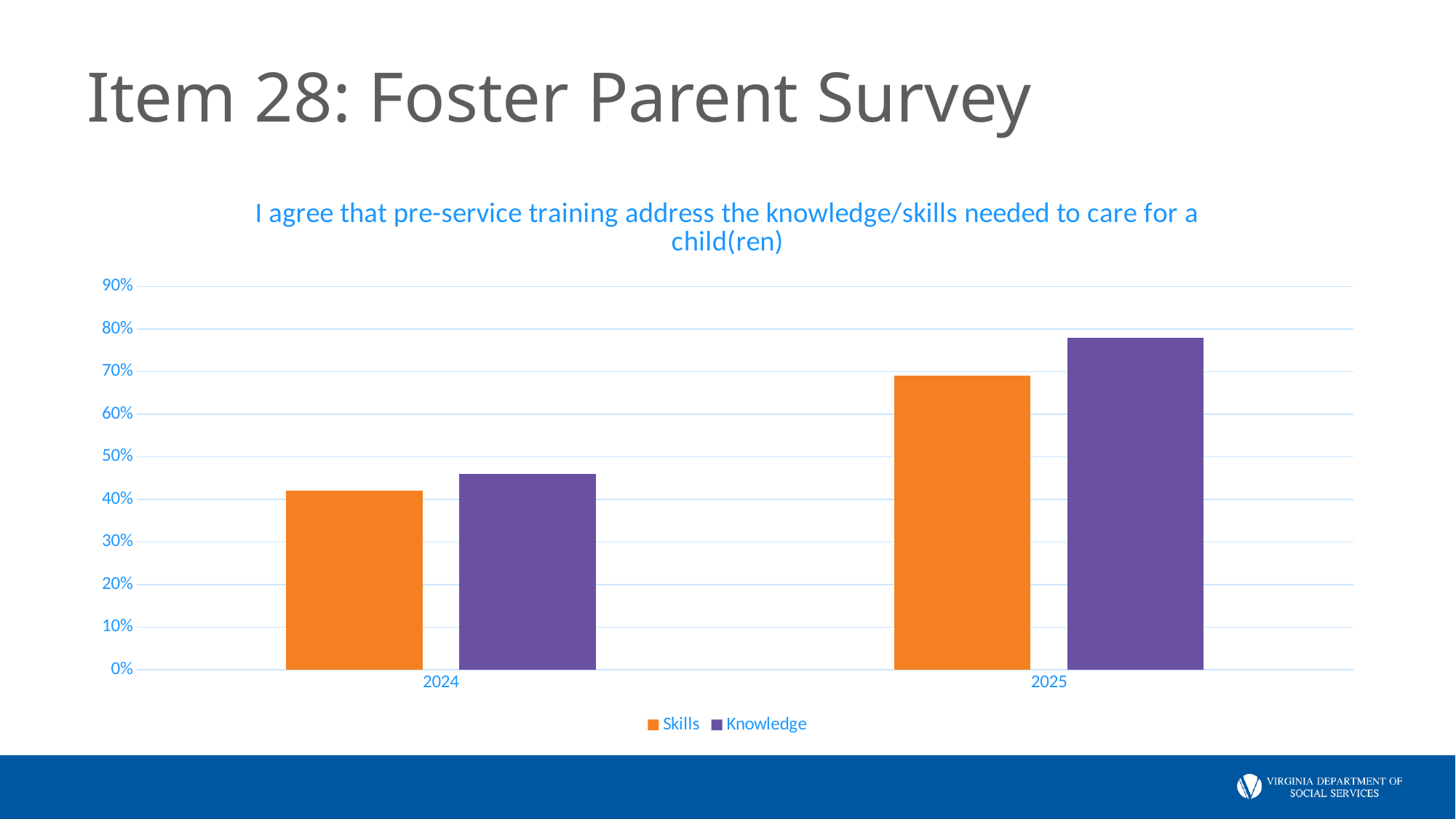
Is the value for Knowledge in 2024 greater or less than 50%? less Is the value for Skills in 2024 greater or less than 50%? less Which bar is the highest in the chart? Knowledge in 2025 Which series is shown in orange? Skills What is the title of the chart? I agree that pre-service training address the knowledge/skills needed to care for a child(ren) Is the value for Skills in 2025 greater or less than 60%? greater How many year categories are shown on the x axis? 2 What kind of chart is shown on the slide? bar chart Which is larger, Skills in 2025 or Knowledge in 2025? Knowledge in 2025 How many series does the legend list? 2 Do the Skills values rise or fall from 2024 to 2025? rise